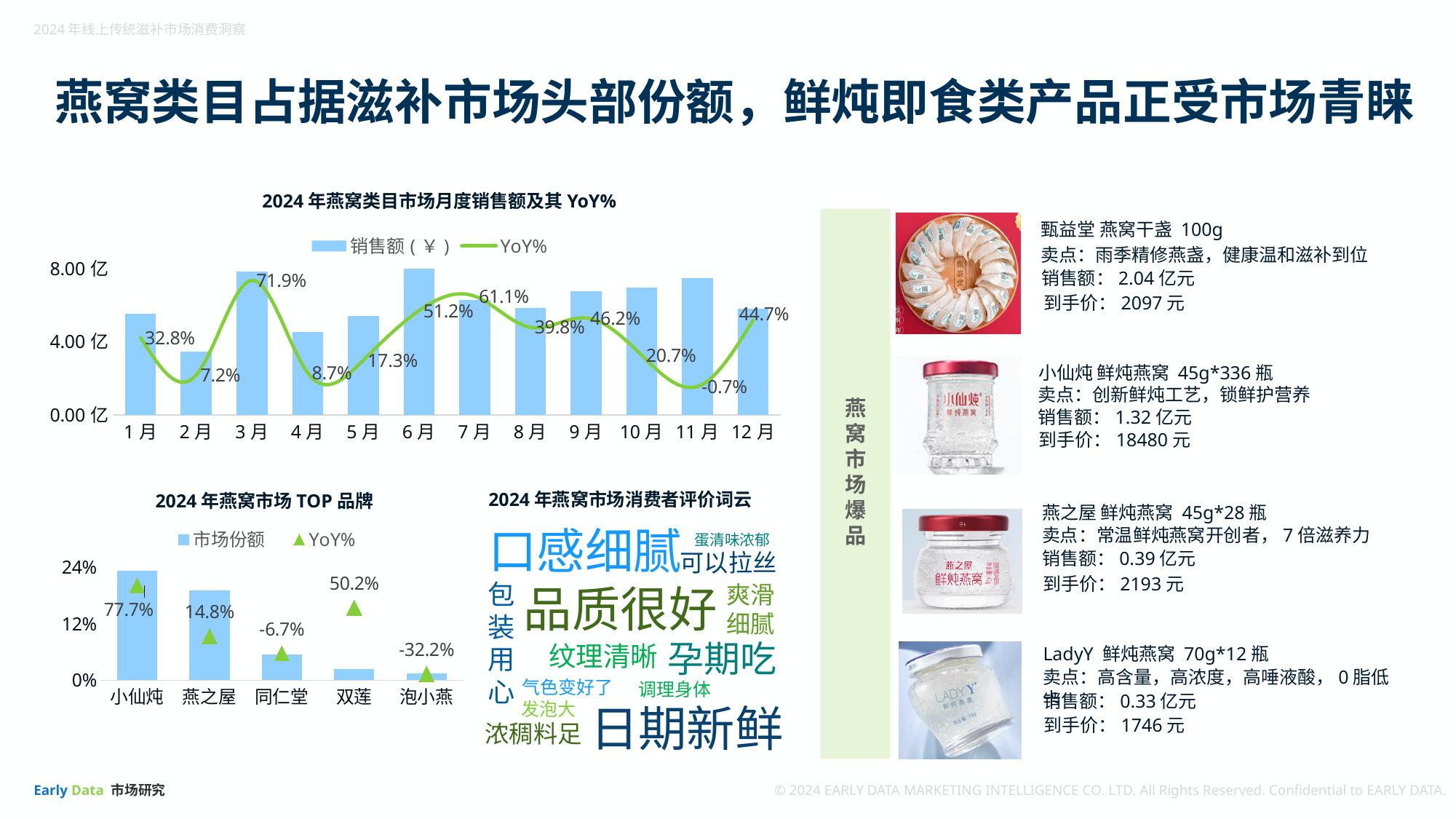
In the chart titled 2024年燕窝类目市场月度销售额及其YoY%, which month has the highest YoY%? 3月 In the chart titled 2024年燕窝类目市场月度销售额及其YoY%, how many series does the legend list? 2 In the chart titled 2024年燕窝市场TOP品牌, how many brands are shown on the x axis? 5 In the chart titled 2024年燕窝类目市场月度销售额及其YoY%, what is the YoY% value for 11月? -0.7% In the chart titled 2024年燕窝市场TOP品牌, is the 市场份额 bar for 小仙炖 greater or less than 12%? greater In the chart titled 2024年燕窝类目市场月度销售额及其YoY%, what is the difference between the YoY% for 7月 and 8月? 21.3% In the chart titled 2024年燕窝市场TOP品牌, which brand has the lowest YoY%? 泡小燕 In the chart titled 2024年燕窝类目市场月度销售额及其YoY%, is the 销售额 bar for 2月 greater or less than 4.00亿? less In the chart titled 2024年燕窝类目市场月度销售额及其YoY%, which month has the lowest YoY%? 11月 In the chart titled 2024年燕窝类目市场月度销售额及其YoY%, which month has the tallest 销售额 bar? 6月 In the chart titled 2024年燕窝类目市场月度销售额及其YoY%, what is the YoY% value for 3月? 71.9% In the chart titled 2024年燕窝市场TOP品牌, what is the YoY% value for 双莲? 50.2%